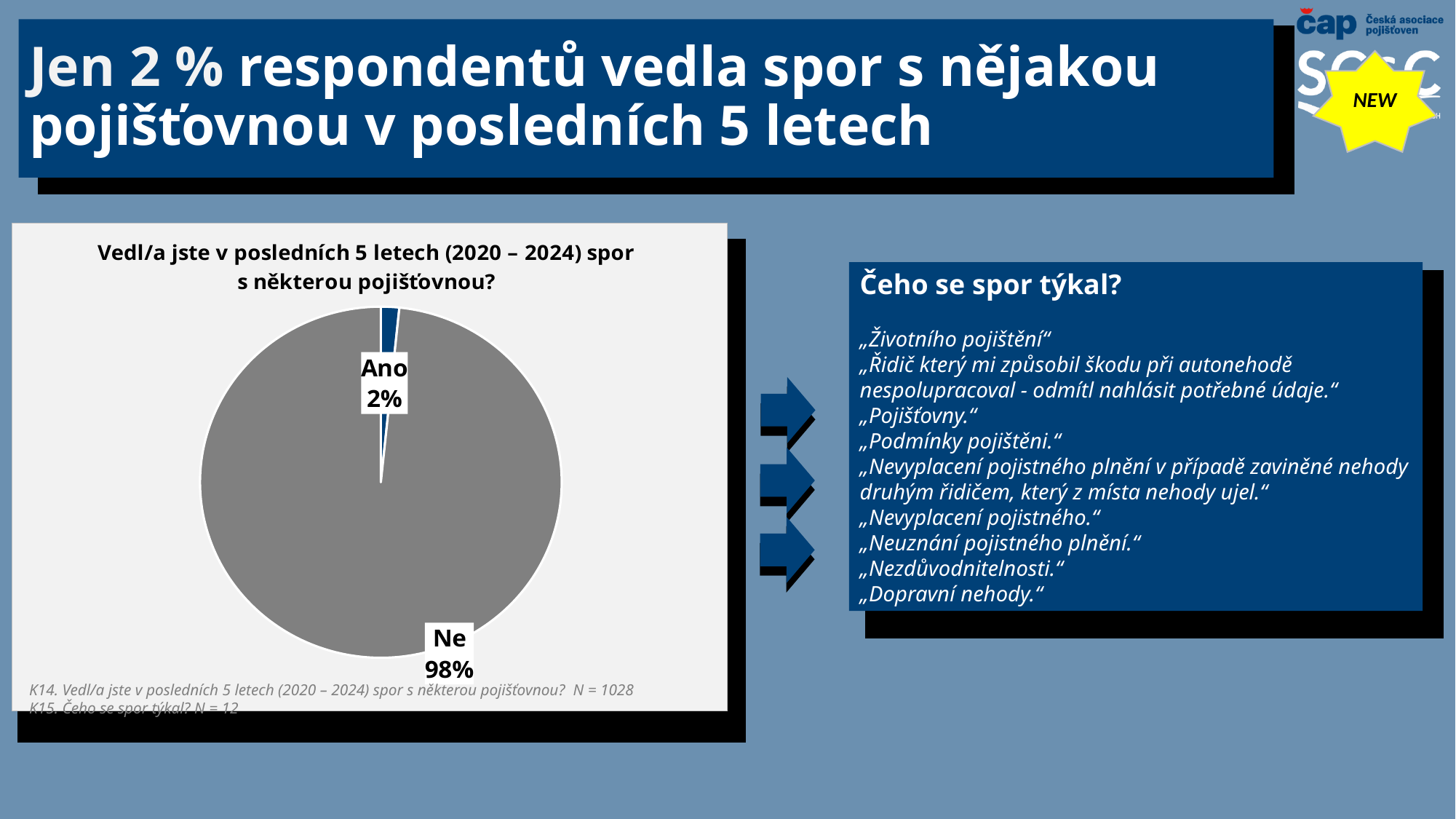
What is the difference in percentage points between the "Ne" and "Ano" slices? 96 What percentage of respondents answered "Ne"? 98% What kind of chart is shown on the slide? pie chart Which slice of the pie is the smallest? Ano What percentage of respondents answered "Ano"? 2% Which slice of the pie is the largest? Ne What colour is the "Ne" slice of the pie chart? grey How many slices does the pie chart have? 2 What is the title of the pie chart? Vedl/a jste v posledních 5 letech (2020 – 2024) spor s některou pojišťovnou? Which is larger, the share for "Ano" or the share for "Ne"? Ne What share of the pie does the "Ne" slice represent? 98%